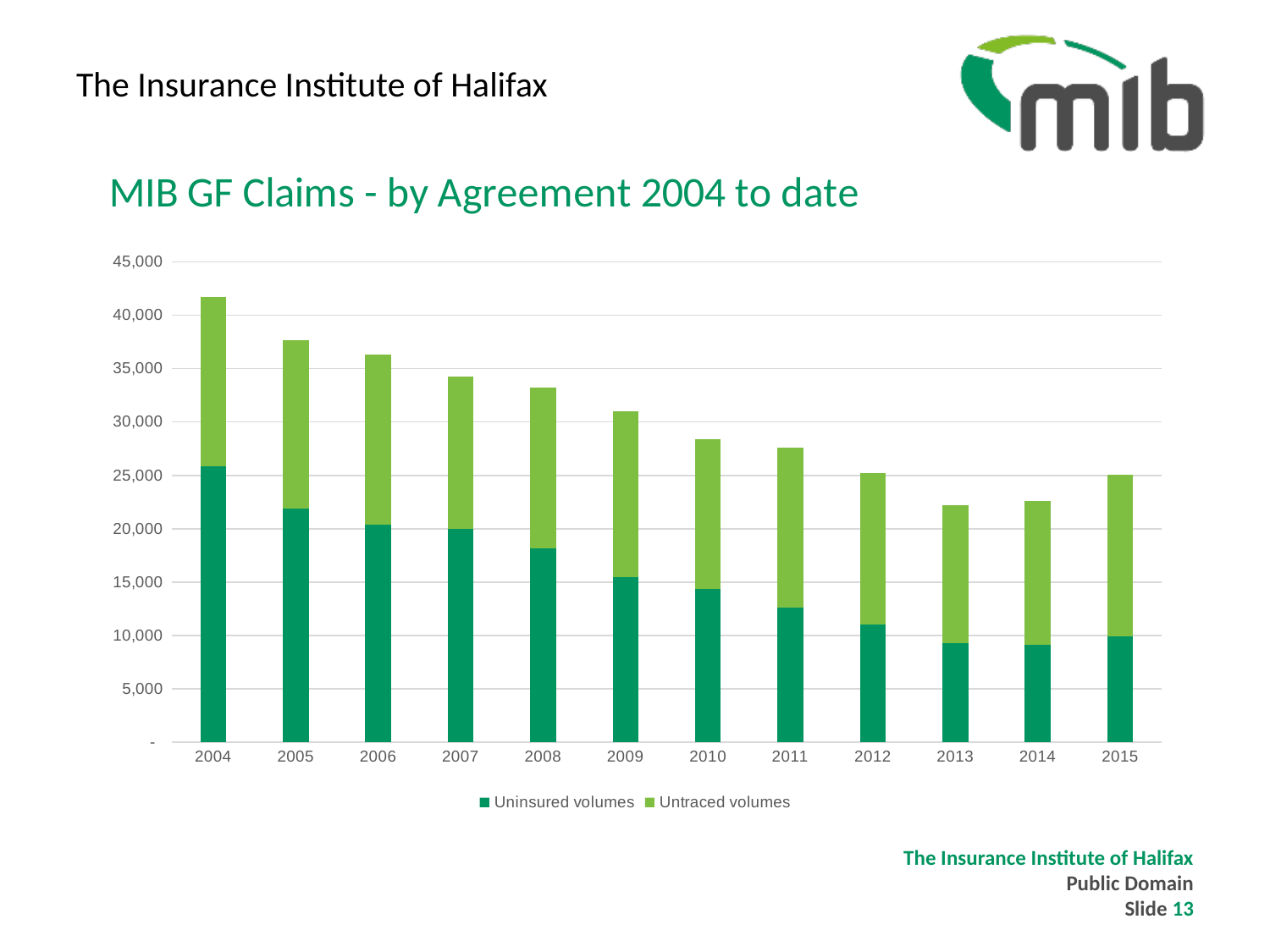
Is the Uninsured volumes value for 2008 greater or less than 20,000? less Is the Uninsured volumes value for 2012 greater or less than 10,000? greater What kind of chart is shown on the slide? Stacked bar chart Which year has the larger total bar, 2014 or 2015? 2015 Which two series are listed in the chart legend? Uninsured volumes and Untraced volumes Is the total bar for 2004 greater or less than 40,000? greater How many series does the chart legend list? 2 What is the title of the chart? MIB GF Claims - by Agreement 2004 to date Which year has the highest total bar in the chart? 2004 Do the Uninsured volumes generally rise or fall from 2004 to 2013? fall How many years are shown on the x axis of the chart? 12